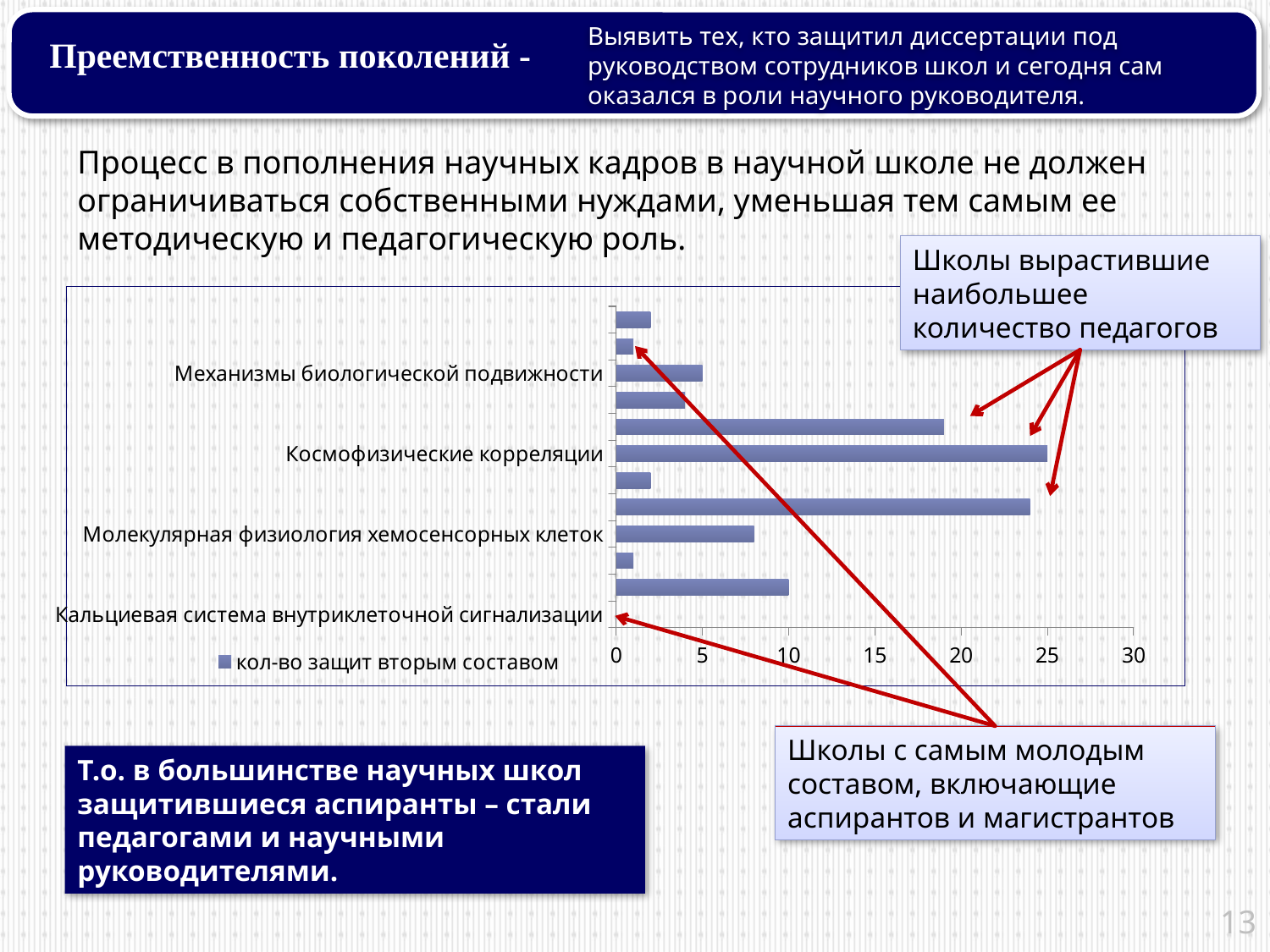
Which has the larger value, Космофизические корреляции or Молекулярная физиология хемосенсорных клеток? Космофизические корреляции Is the value for Молекулярная физиология хемосенсорных клеток greater or less than 5? greater Which has the larger value, Молекулярная физиология хемосенсорных клеток or Механизмы биологической подвижности? Молекулярная физиология хемосенсорных клеток Is the value for Молекулярная физиология хемосенсорных клеток greater or less than 10? less What is the highest value shown on the horizontal axis of the chart? 30 Is the value for Кальциевая система внутриклеточной сигнализации greater or less than 5? less How many series does the chart legend list? 1 Which of the labelled categories has the highest value? Космофизические корреляции What kind of chart is shown on the slide? bar chart What is the name of the series shown in the chart legend? кол-во защит вторым составом